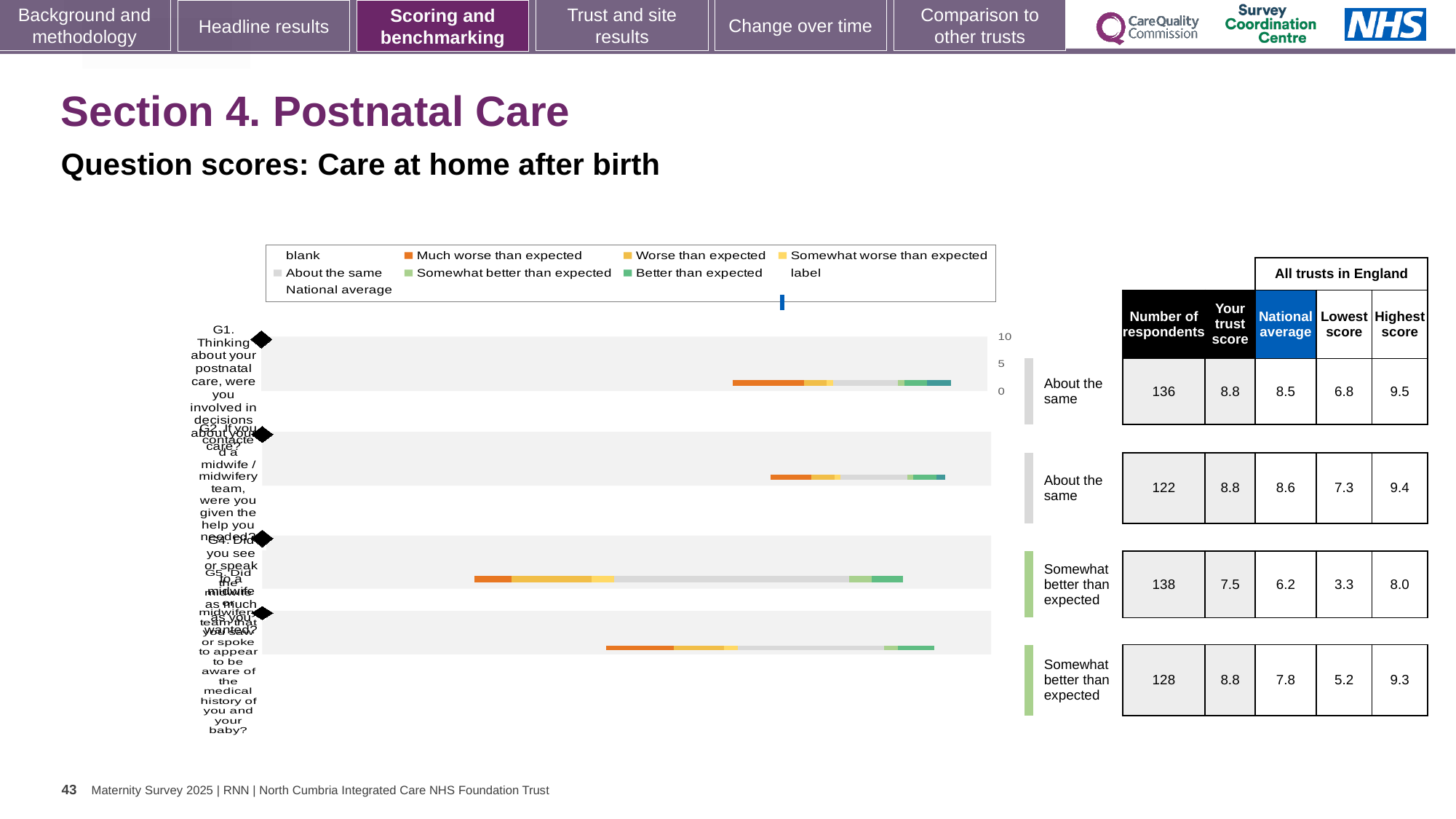
Which colour does the legend use for 'Much worse than expected'? orange What is the highest tick value shown on the chart's score axis? 10 In the table beside the chart, what is the 'Your trust score' for the first row (G1)? 8.8 In the table beside the chart, what is the national average for the third row (G4)? 6.2 How many entries does the chart legend list? 9 In the table beside the chart, which row has the lowest 'Your trust score'? the third row (G4), 7.5 What benchmark category label is shown next to the first bar (G1)? About the same In the table beside the chart, is the trust score for the first row (G1) larger or smaller than the national average? larger In the table beside the chart, what is the number of respondents for the second row (G2)? 122 What kind of chart is shown on the slide? bar chart In the table beside the chart, what is the difference between the trust score and the national average for the fourth row (G5)? 1.0 How many question bars are plotted in the chart? 4